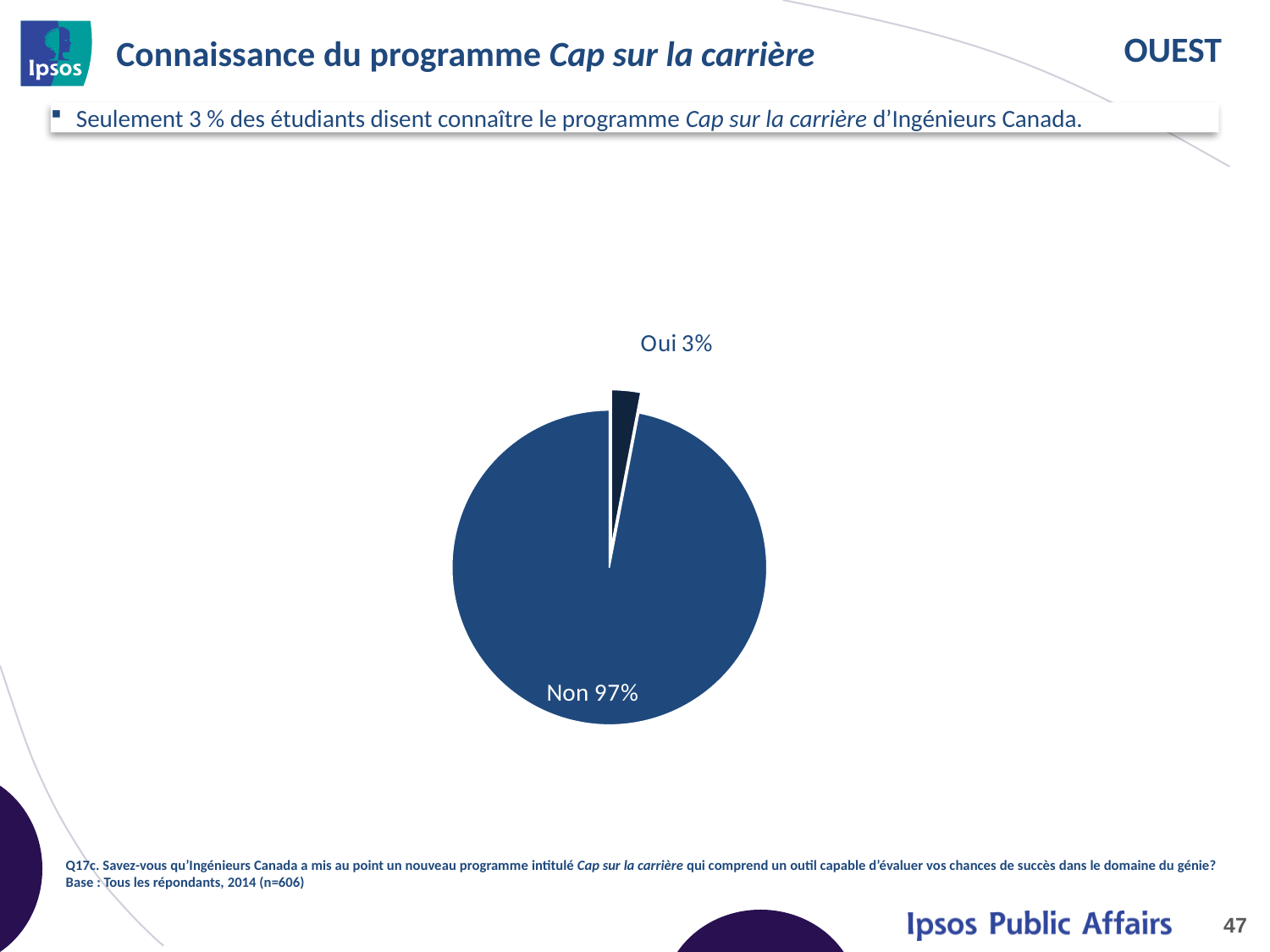
Which is larger, the "Oui" slice or the "Non" slice? Non Which slice of the pie is the largest? Non What type of chart is shown on the slide? pie chart What is the title of the slide containing the pie chart? Connaissance du programme Cap sur la carrière What is the total of the two slices shown in the pie chart? 100% What percentage of students answered "Oui"? 3% Which slice of the pie is the smallest? Oui What share of the pie does the "Non" slice represent? 97% What is the sample size (n) stated in the base note below the chart? 606 What percentage of students answered "Non"? 97% How many slices does the pie chart have? 2 What is the difference in percentage points between the "Non" and "Oui" slices? 94